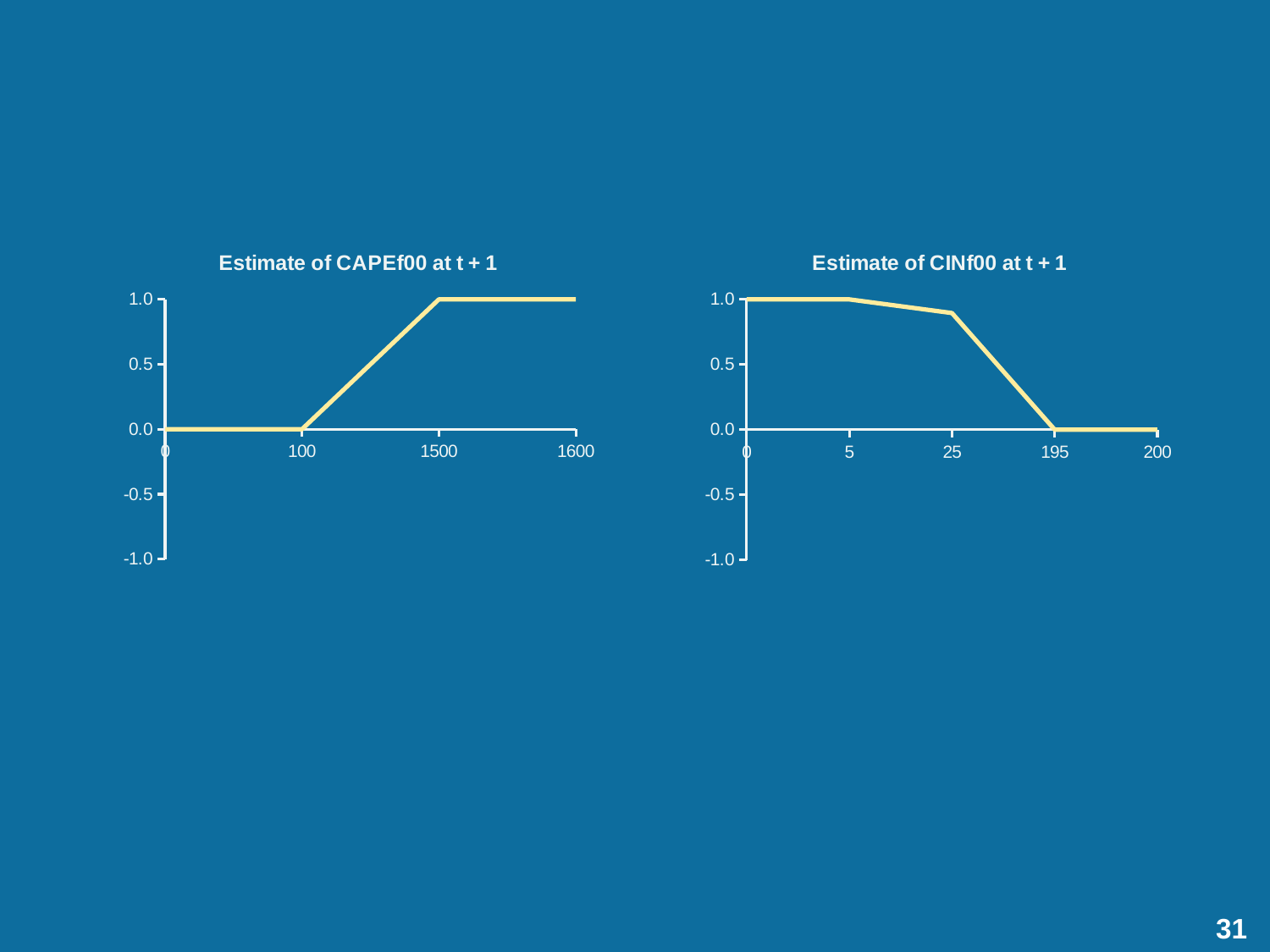
In the 'Estimate of CINf00 at t + 1' chart, how many x-axis tick labels are shown? 5 In the 'Estimate of CINf00 at t + 1' chart, what is the value at x = 195? 0.0 In the 'Estimate of CAPEf00 at t + 1' chart, what is the value at x = 1500? 1.0 What kind of chart is the 'Estimate of CAPEf00 at t + 1' chart? line chart In the 'Estimate of CINf00 at t + 1' chart, which is larger: the value at x = 5 or the value at x = 200? x = 5 What is the title of the chart on the right side of the slide? Estimate of CINf00 at t + 1 In the 'Estimate of CINf00 at t + 1' chart, is the value at x = 25 greater or less than 0.5? greater In the 'Estimate of CINf00 at t + 1' chart, does the line rise or fall between x = 25 and x = 195? fall In the 'Estimate of CAPEf00 at t + 1' chart, what is the value at x = 100? 0.0 In the 'Estimate of CINf00 at t + 1' chart, what is the value at x = 5? 1.0 In the 'Estimate of CAPEf00 at t + 1' chart, does the line rise or fall between x = 100 and x = 1500? rise In the 'Estimate of CAPEf00 at t + 1' chart, how many x-axis tick labels are shown? 4